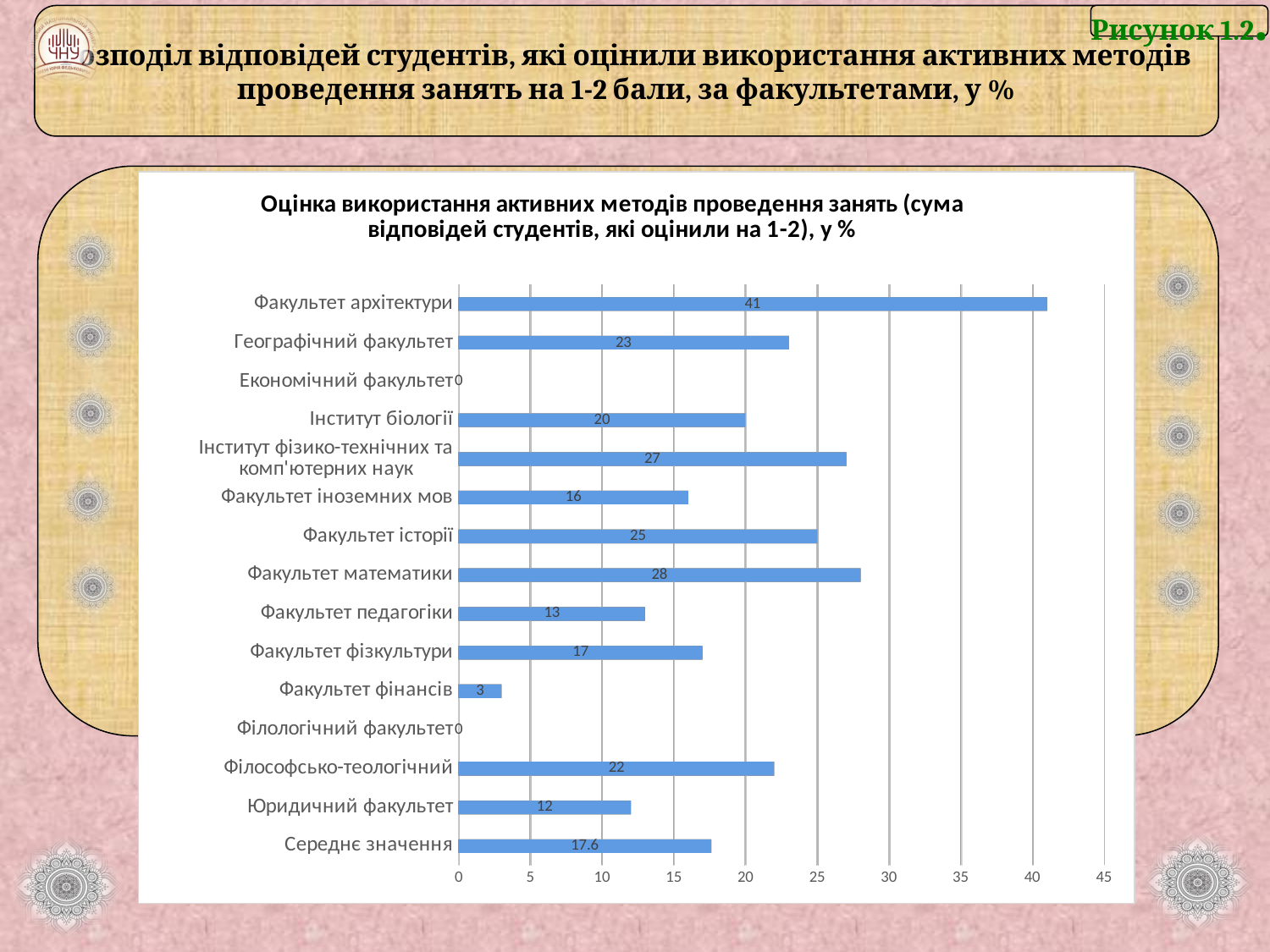
What is the value for Факультет фінансів? 3 What is the highest value shown on the horizontal axis? 45 How many categories are shown on the chart? 15 What is the difference between the values for Факультет математики and Факультет педагогіки? 15 What is the value for Факультет архітектури? 41 Which is larger, the value for Географічний факультет or the value for Філософсько-теологічний? Географічний факультет Is the value for Факультет історії greater or less than 20? greater How many categories have a value of 0? 2 What is the value for Інститут фізико-технічних та комп'ютерних наук? 27 Which category has the highest value? Факультет архітектури What kind of chart is shown on the slide? bar chart What is the value for Середнє значення? 17.6